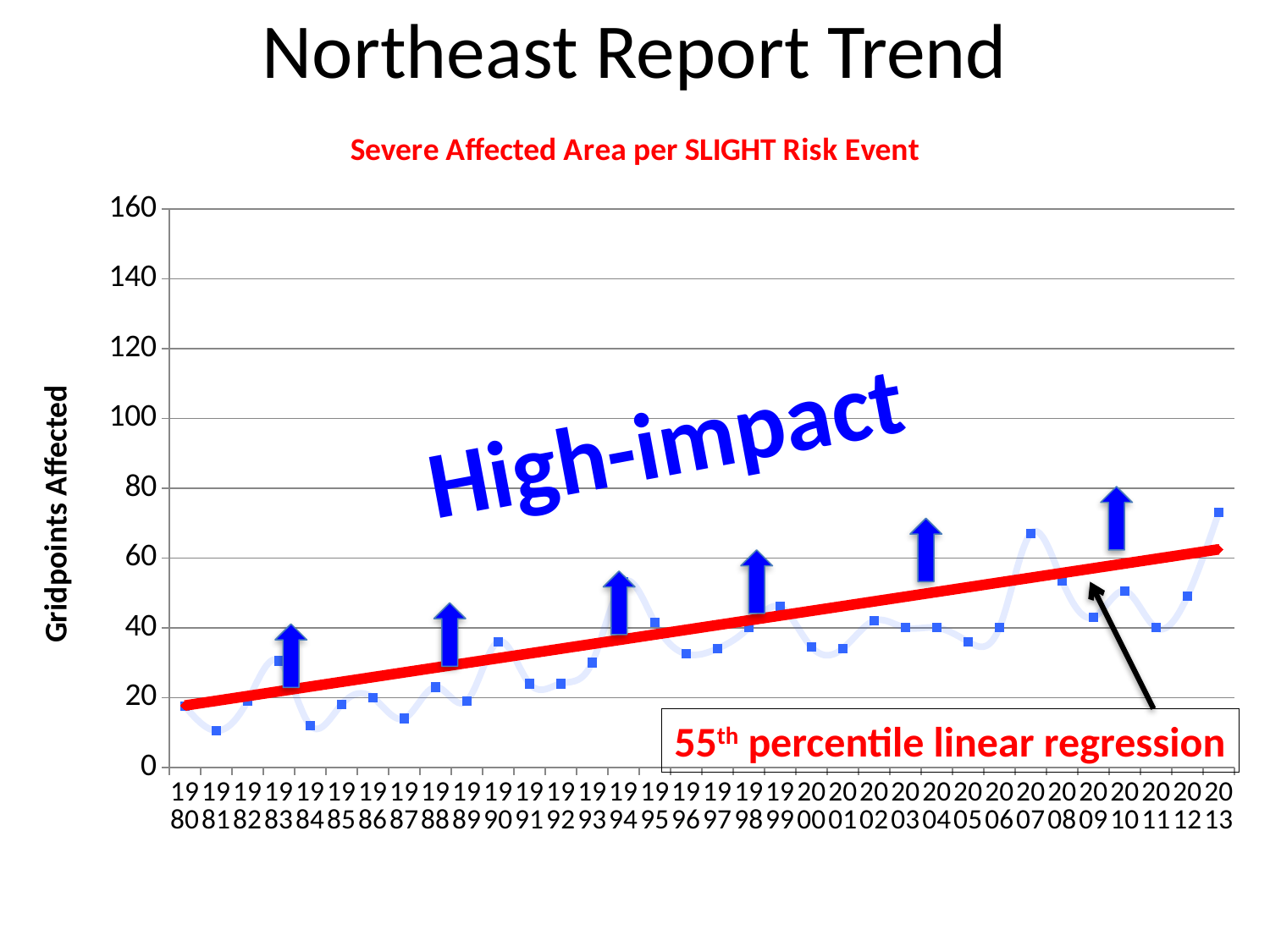
Which year has the larger value, 2013 or 1981? 2013 Is the value for 2001 greater or less than 40? less What kind of chart is shown on the slide? line chart Do the values generally rise or fall from 1980 to 2013 according to the red regression line? rise How many years are plotted along the x axis of the chart? 34 Is the value for 2007 greater or less than 60? greater What is the title of the chart? Severe Affected Area per SLIGHT Risk Event Is the value for 1987 greater or less than 20? less Which year has the larger value, 2007 or 1985? 2007 What is the label on the vertical axis of the chart? Gridpoints Affected